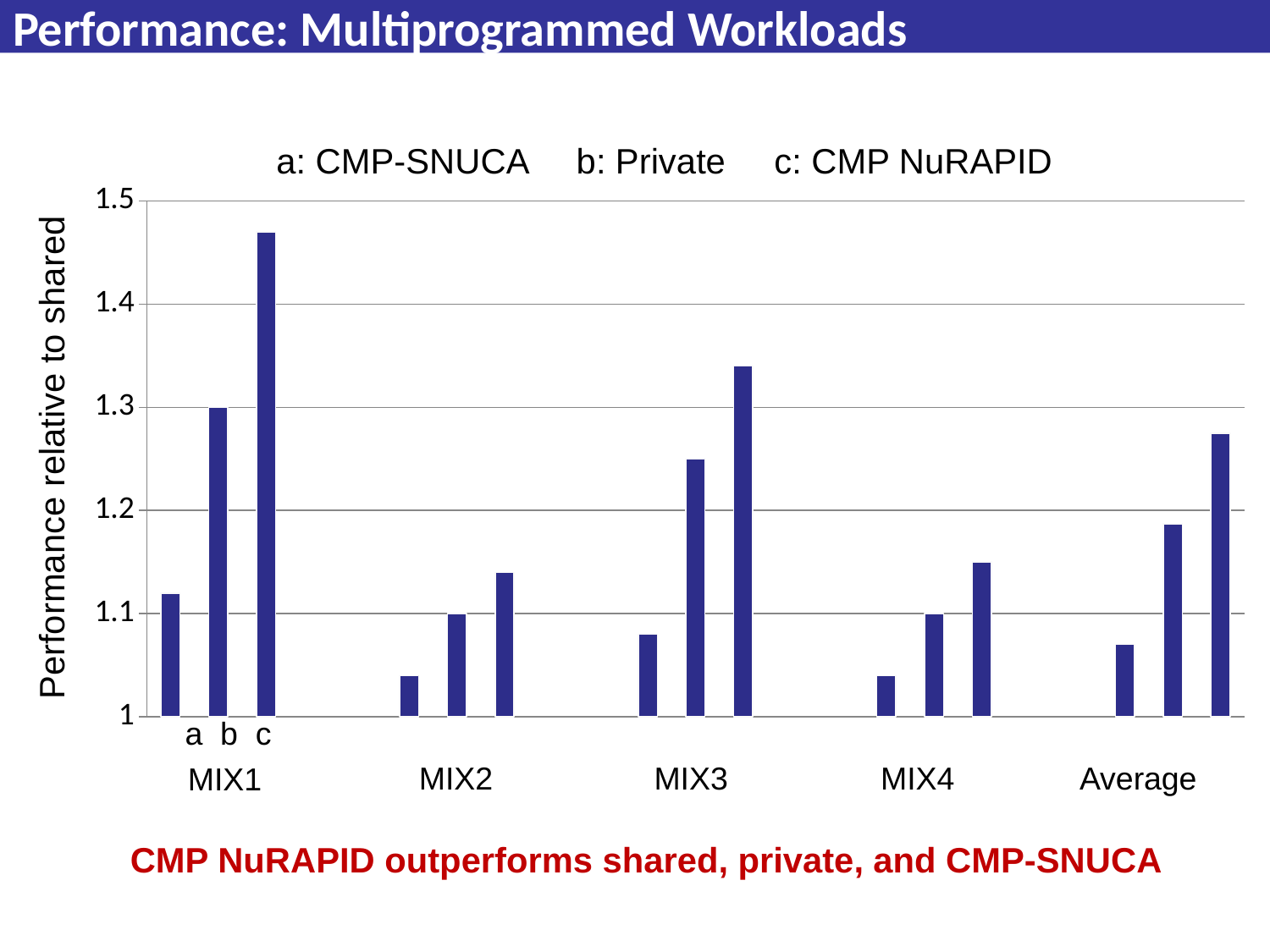
How many workload categories are shown along the x axis? 5 What is the label of the y axis? Performance relative to shared Is the CMP NuRAPID (c) value for MIX1 greater or less than 1.4? greater Is the CMP NuRAPID (c) value for Average greater or less than 1.2? greater Which is larger: the Private (b) value for MIX1 or the Private (b) value for MIX3? MIX1 Is the CMP NuRAPID (c) value for MIX3 greater or less than 1.3? greater Within MIX1, which configuration has the tallest bar? c: CMP NuRAPID Which category has the highest CMP NuRAPID (c) bar? MIX1 What kind of chart is shown on the slide? bar chart How many configurations (series) does the legend list? 3 Which category has the highest Private (b) bar? MIX1